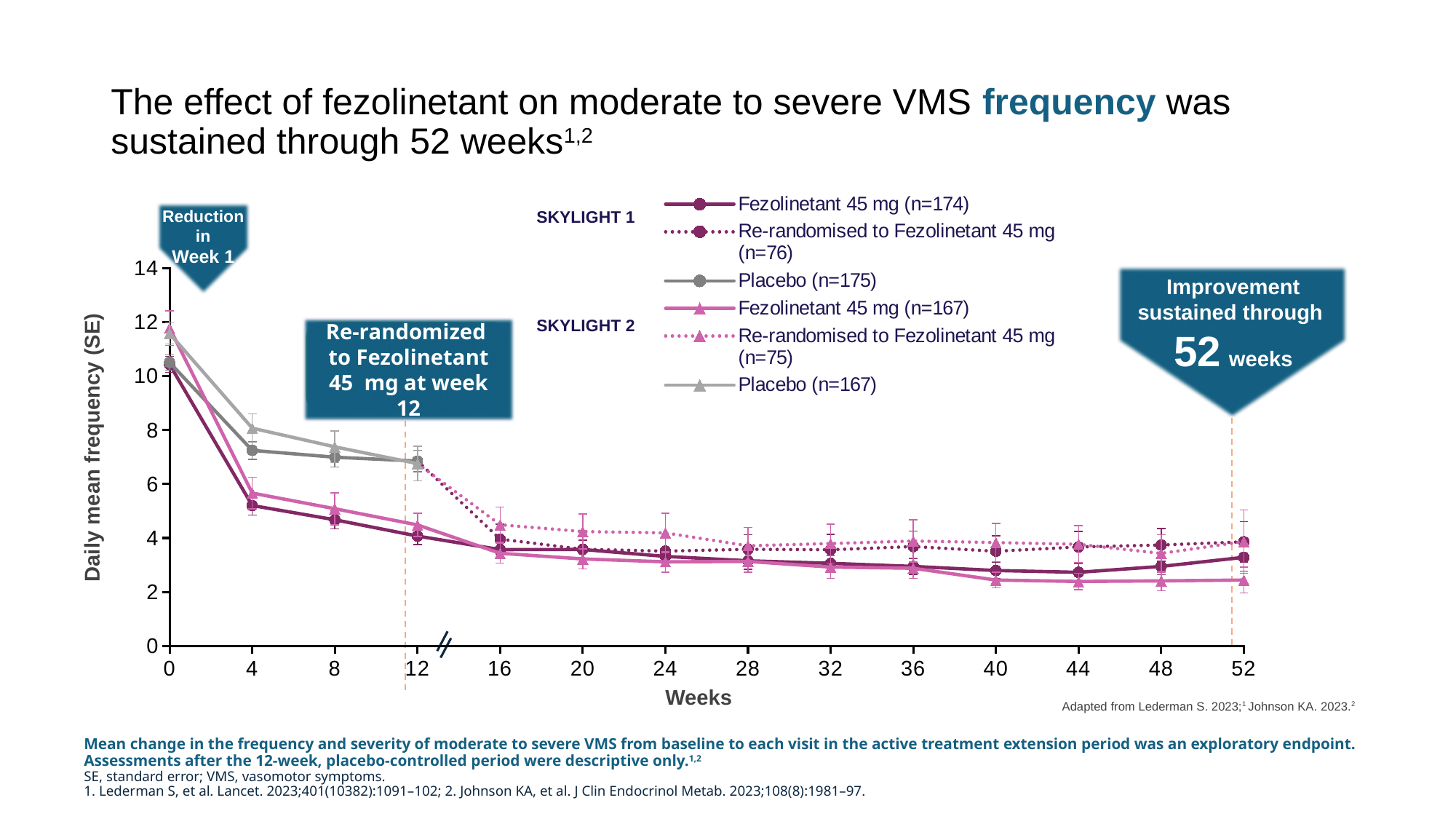
How many series does the legend list? 6 Is the value for Placebo (n=175) at week 4 greater or less than 8? less What is the label of the y-axis? Daily mean frequency (SE) What kind of chart is shown on the slide? Line chart How many week tick marks are shown on the x-axis? 14 Is the value for Fezolinetant 45 mg (n=174) at week 4 greater or less than 6? less Is the value for Fezolinetant 45 mg (n=167) at week 52 greater or less than 4? less What is the label of the x-axis? Weeks At week 52, which is higher: Re-randomised to Fezolinetant 45 mg (n=76) or Fezolinetant 45 mg (n=167)? Re-randomised to Fezolinetant 45 mg (n=76) Does the value for Fezolinetant 45 mg (n=174) rise or fall from week 0 to week 12? Fall At week 4, which is higher: Placebo (n=175) or Fezolinetant 45 mg (n=174)? Placebo (n=175)